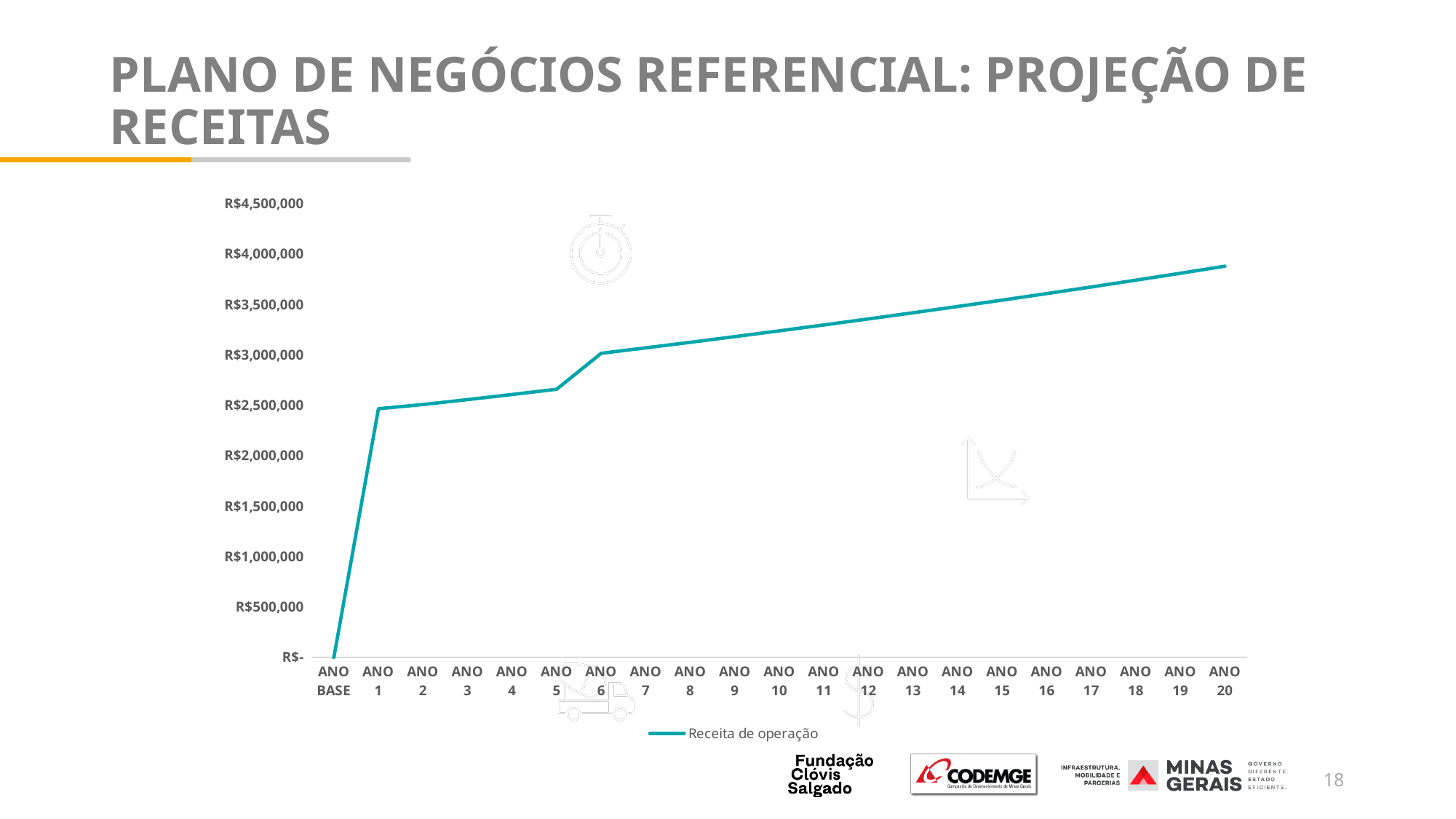
Is the value for ANO 20 greater or less than R$4,000,000? less What kind of chart is shown on the slide? line chart Is the value for ANO 10 greater or less than R$3,000,000? greater How many points are plotted along the x axis, from ANO BASE to ANO 20? 21 Do the values of Receita de operação rise or fall from ANO BASE to ANO 20? rise What is the name of the series shown in the legend? Receita de operação How many series does the legend list? 1 Is the value for ANO 5 greater or less than R$2,500,000? greater What is the value of Receita de operação at ANO BASE? R$- Which is larger, the value for ANO 10 or the value for ANO 5? ANO 10 Which year has the highest Receita de operação? ANO 20 Which year has the lowest Receita de operação? ANO BASE